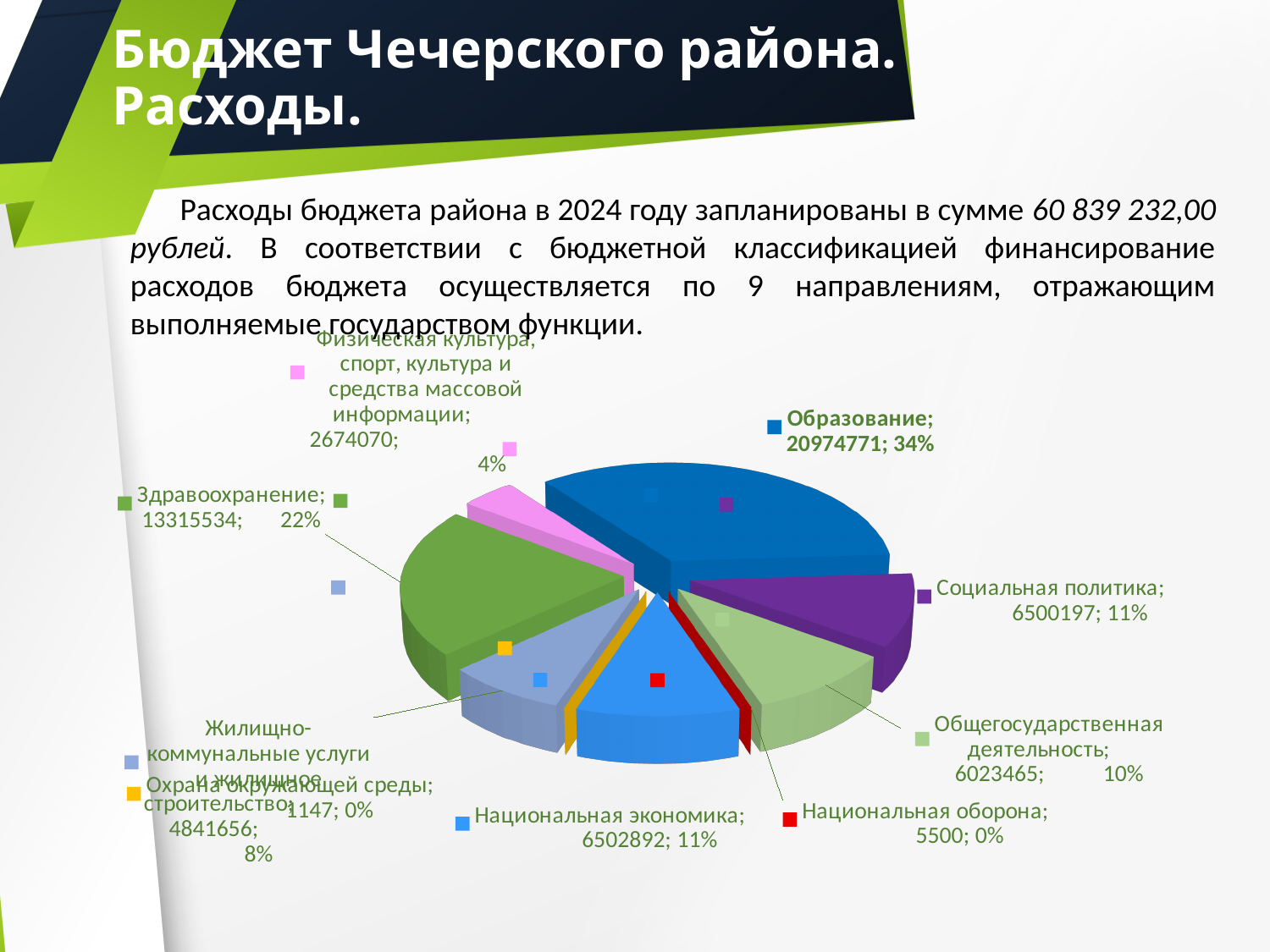
Which category has the largest slice of the pie chart? Образование What kind of chart is shown on the slide? Pie chart Which category has the smallest value in the pie chart? Охрана окружающей среды What share of the pie does Жилищно-коммунальные услуги и жилищное строительство represent? 8% What value is shown for Общегосударственная деятельность in the pie chart? 6023465 What value is shown for Образование in the pie chart? 20974771 How many categories are shown in the pie chart? 9 What is the difference between the values for Образование and Здравоохранение? 7659237 What value is shown for Здравоохранение in the pie chart? 13315534 What value is shown for Национальная оборона in the pie chart? 5500 Which is larger, the value for Национальная экономика or the value for Социальная политика? Национальная экономика What share of the pie does Здравоохранение represent? 22%